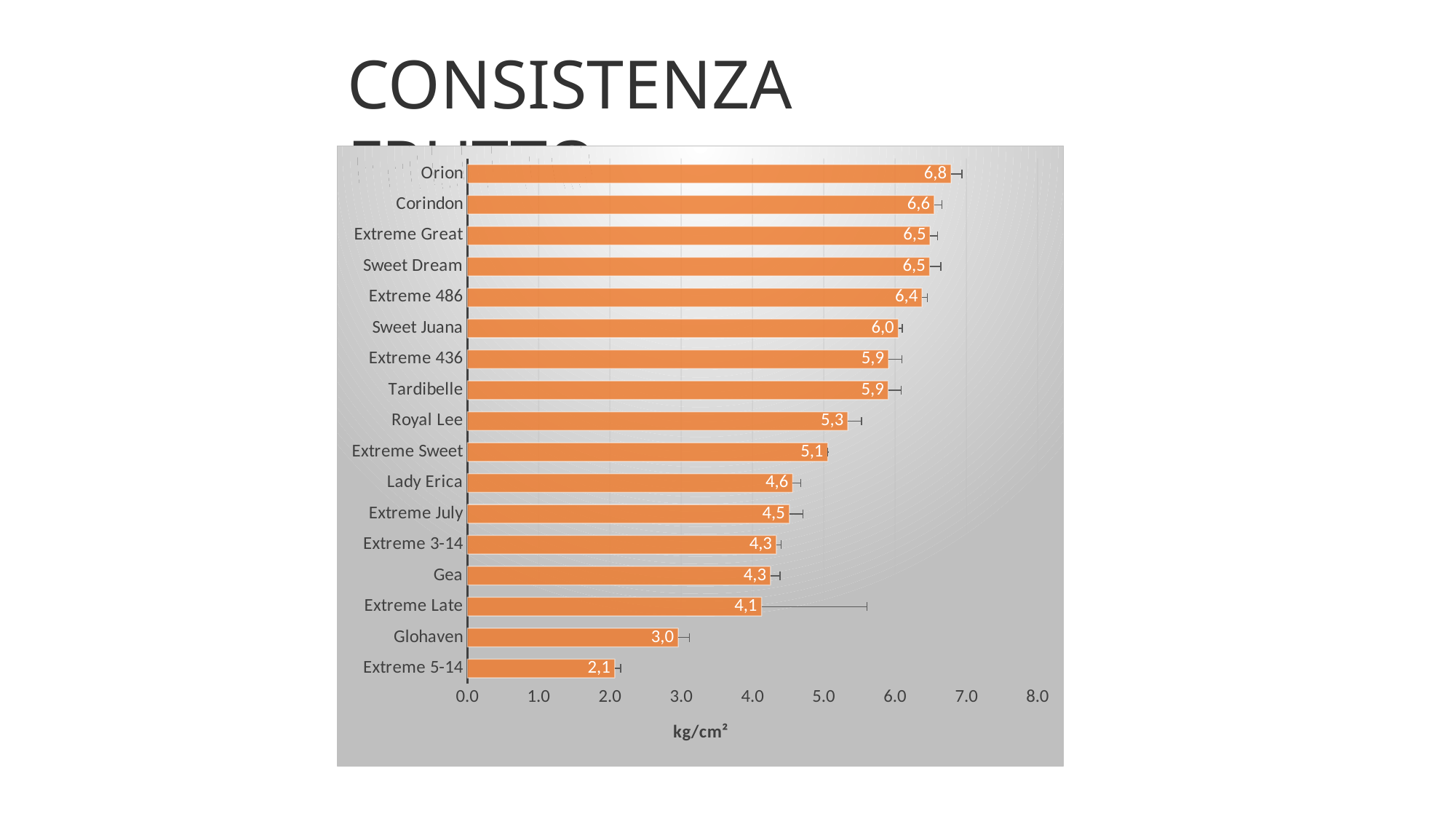
Which category has the lowest value? Extreme 5-14 How many categories are shown in the chart? 17 What is the value for Royal Lee? 5,3 What is the difference between the values for Corindon and Extreme 486? 0,2 Is the value for Extreme Late greater or less than 5.0? less What unit is shown on the horizontal axis label? kg/cm² Which category has the highest value? Orion What is the value for Glohaven? 3,0 What is the difference between the values for Orion and Extreme 5-14? 4,7 Which has a larger value, Sweet Juana or Lady Erica? Sweet Juana What kind of chart is shown on the slide? bar chart What is the value for Orion? 6,8